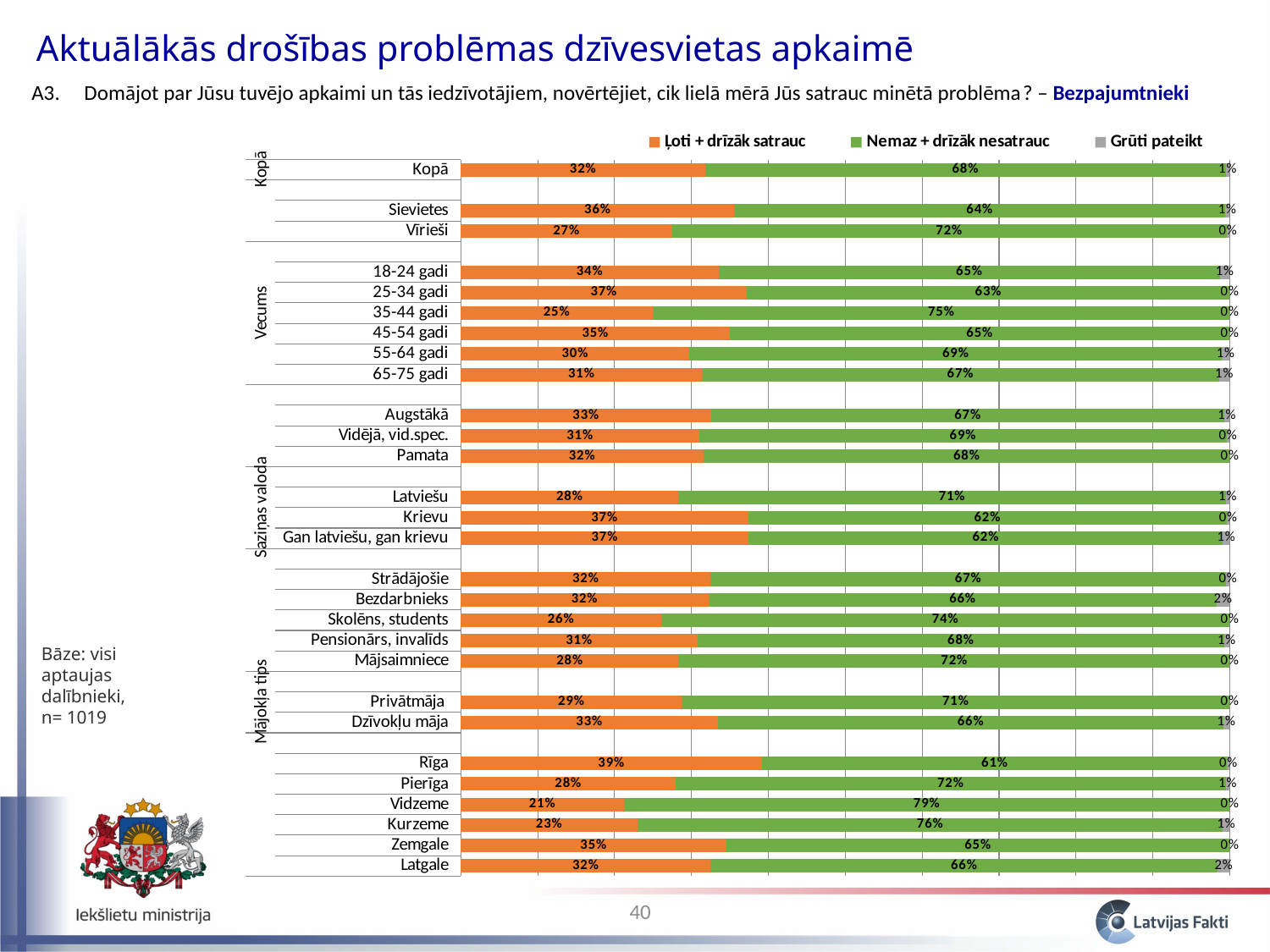
Which has a larger "Ļoti + drīzāk satrauc" value, 25-34 gadi or 35-44 gadi? 25-34 gadi How many series does the legend list? 3 What kind of chart is shown on the slide? Stacked bar chart What is the value of "Nemaz + drīzāk nesatrauc" for Vīrieši? 72% Which category has the lowest value for "Ļoti + drīzāk satrauc"? Vidzeme Which category has the highest value for "Nemaz + drīzāk nesatrauc"? Vidzeme What is the value of "Ļoti + drīzāk satrauc" for Kopā? 32% Which series is shown in orange in the legend? Ļoti + drīzāk satrauc What is the value of "Grūti pateikt" for Bezdarbnieks? 2% How many categories are plotted in the chart? 28 Which category has the highest value for "Ļoti + drīzāk satrauc"? Rīga What is the difference between the "Ļoti + drīzāk satrauc" values for Sievietes and Vīrieši? 9 percentage points